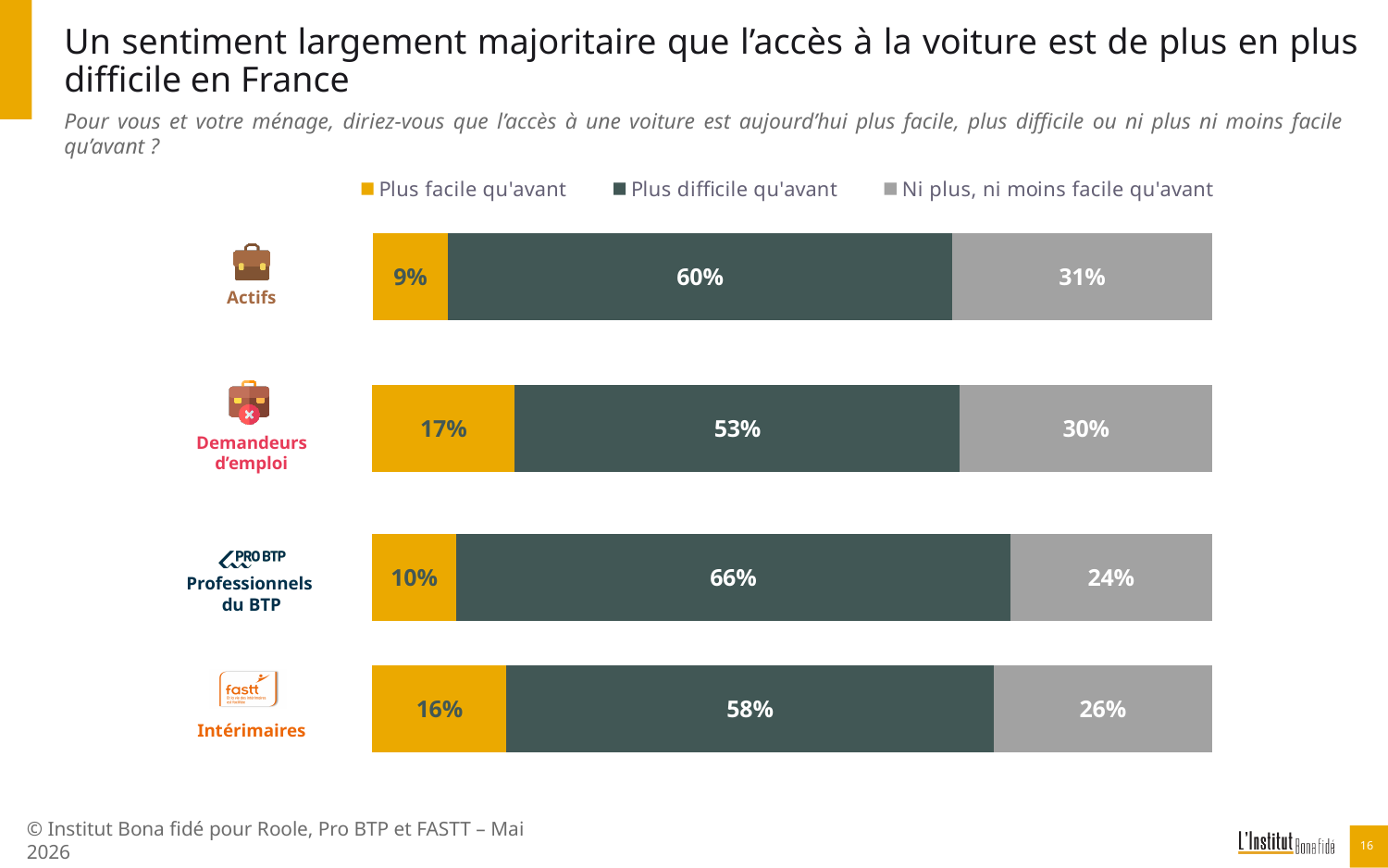
How many groups (categories) are shown in the chart? 4 What is the difference between the 'Plus difficile qu'avant' shares for Professionnels du BTP and Demandeurs d'emploi? 13 percentage points Which colour represents 'Plus facile qu'avant' in the chart? Yellow/orange What percentage of Actifs say access to a car is 'Plus difficile qu'avant'? 60% What percentage of Professionnels du BTP answer 'Ni plus, ni moins facile qu'avant'? 24% How many series does the legend list? 3 What percentage of Demandeurs d'emploi say access to a car is 'Plus facile qu'avant'? 17% What percentage of Intérimaires say access to a car is 'Plus difficile qu'avant'? 58% Which is larger: the 'Plus facile qu'avant' share for Demandeurs d'emploi or for Intérimaires? Demandeurs d'emploi What kind of chart is shown on the slide? Stacked bar chart Which group has the lowest share answering 'Plus facile qu'avant'? Actifs Which group has the highest share answering 'Plus difficile qu'avant'? Professionnels du BTP